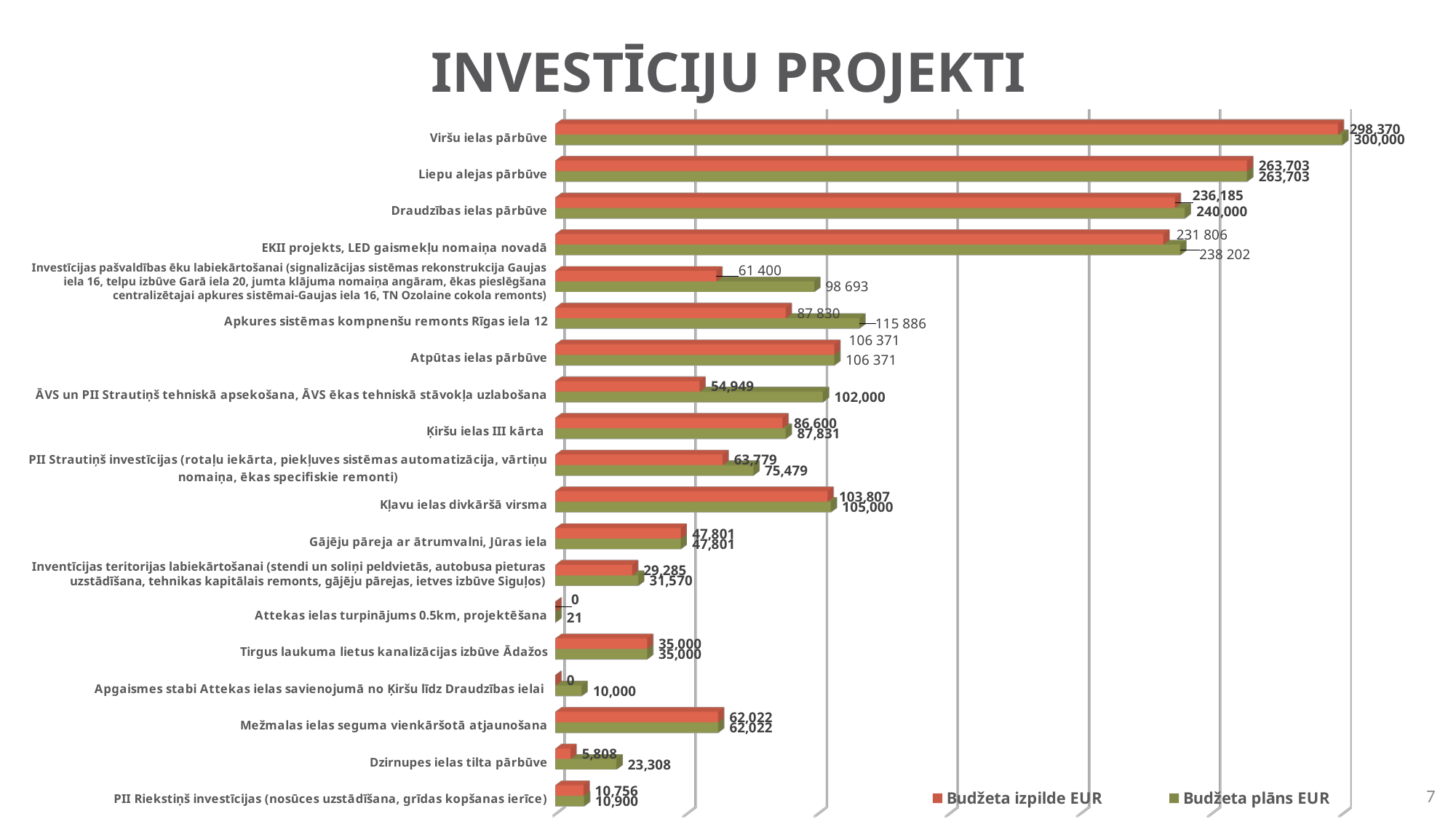
What is the difference between the Budžeta plāns EUR and Budžeta izpilde EUR values for Dzirnupes ielas tilta pārbūve? 17,500 Which colour represents Budžeta plāns EUR in the chart? Green Which is larger: the Budžeta izpilde EUR value for Kļavu ielas divkāršā virsma or for Atpūtas ielas pārbūve? Atpūtas ielas pārbūve What is the Budžeta izpilde EUR value for Viršu ielas pārbūve? 298,370 How many series does the legend list? 2 What is the Budžeta plāns EUR value for Dzirnupes ielas tilta pārbūve? 23,308 Which project has the lowest Budžeta plāns EUR value? Attekas ielas turpinājums 0.5km, projektēšana What is the difference between the Budžeta plāns EUR and Budžeta izpilde EUR values for Viršu ielas pārbūve? 1,630 What kind of chart is shown on the slide? Bar chart Which project has the highest Budžeta plāns EUR value? Viršu ielas pārbūve What is the Budžeta plāns EUR value for Apkures sistēmas kompnenšu remonts Rīgas iela 12? 115 886 How many projects (categories) are shown in the chart? 19